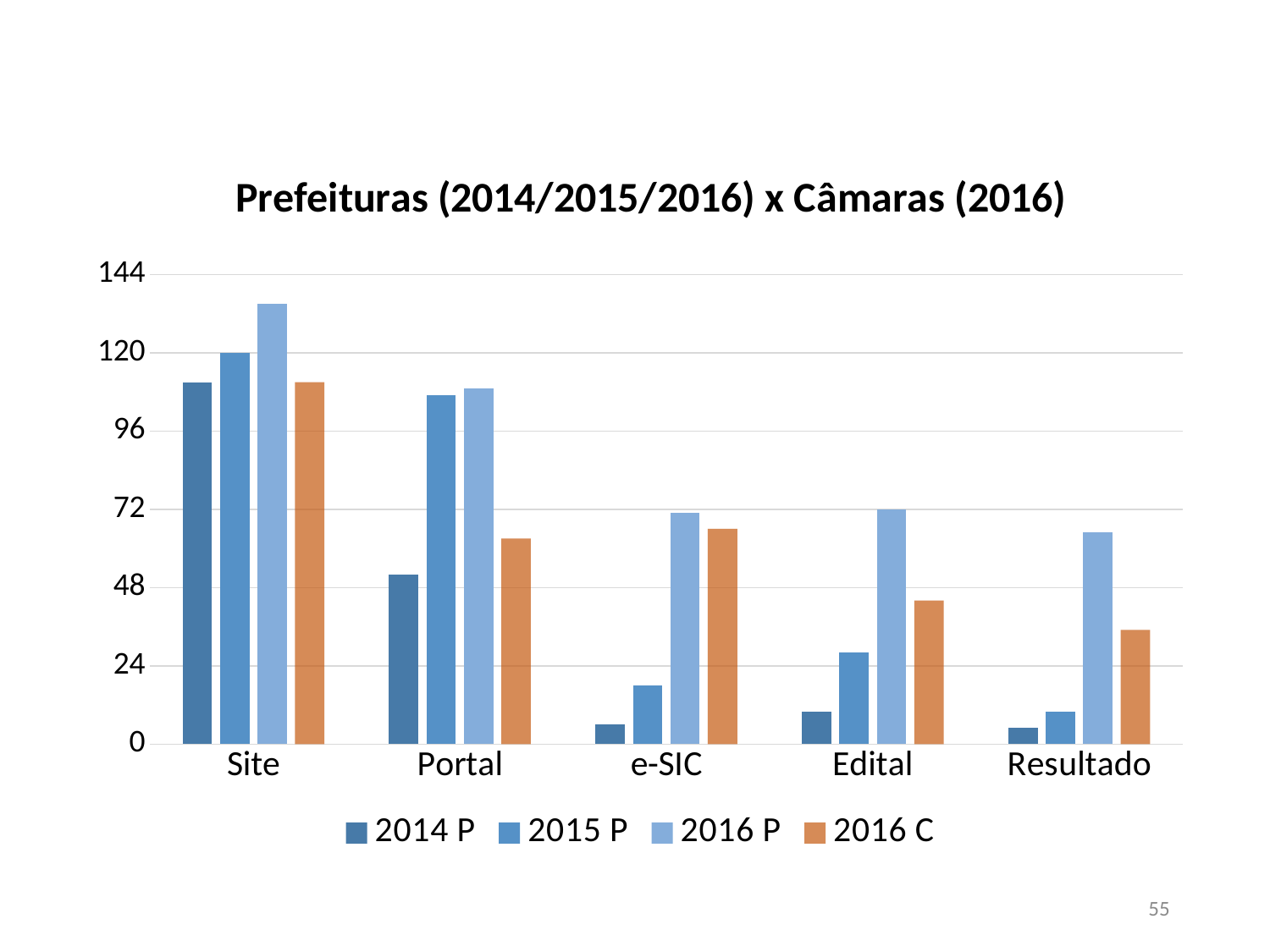
Is the value for 2016 P in the Site category greater or less than 120? greater How many categories are shown on the x axis? 5 What is the title of the chart? Prefeituras (2014/2015/2016) x Câmaras (2016) Is the value for 2016 C in the Portal category greater or less than 72? less Is the value for 2014 P in the e-SIC category greater or less than 24? less In the Portal category, which is larger: the 2014 P value or the 2016 C value? 2016 C How many series does the legend list? 4 What kind of chart is shown on the slide? bar chart What is the value for 2016 P in the Edital category? 72 Which category has the highest value for the 2016 P series? Site What is the value for 2015 P in the Site category? 120